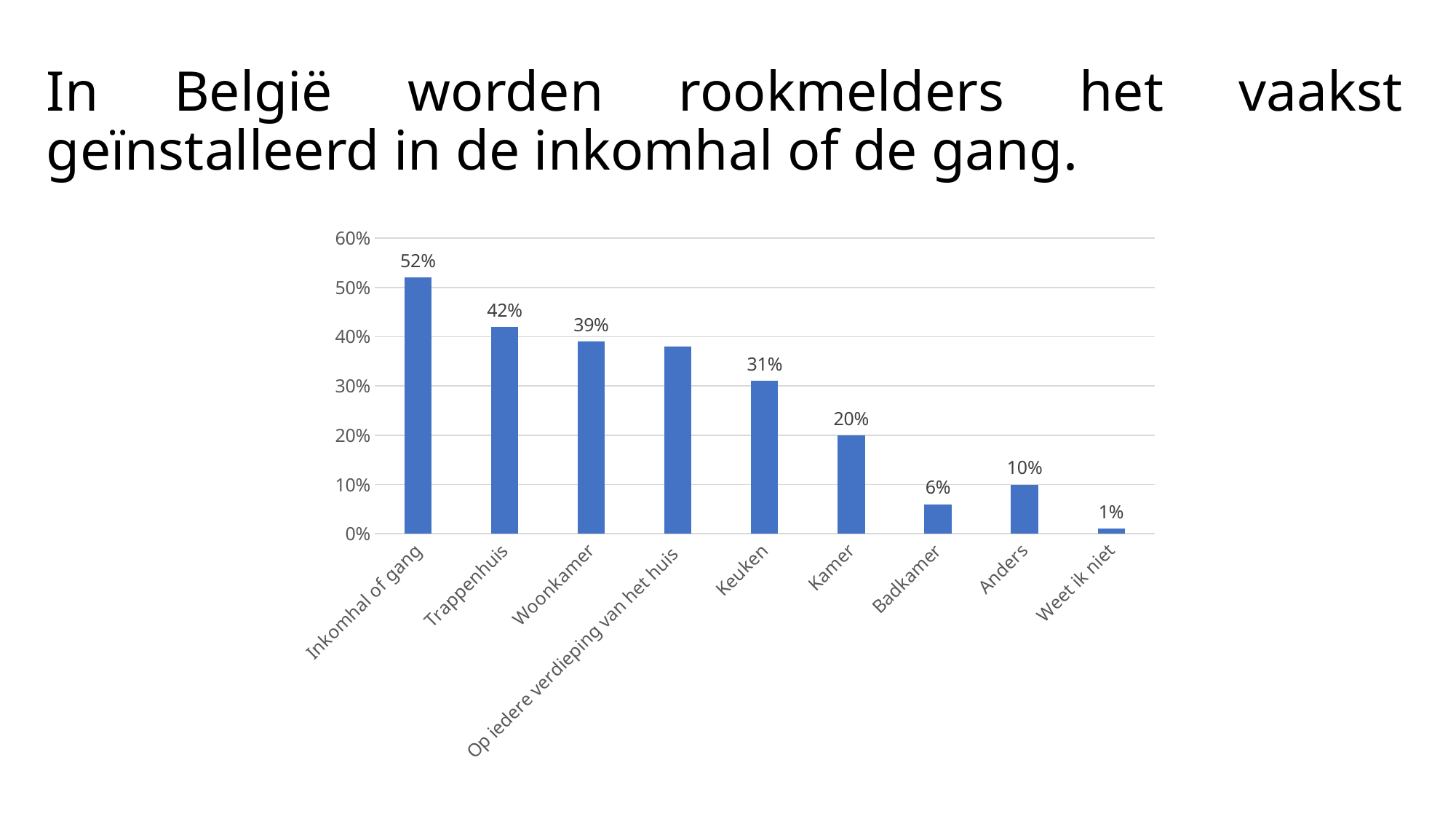
What colour are the bars in the chart? blue What kind of chart is shown on the slide? bar chart What is the difference between the values for Inkomhal of gang and Keuken? 21% Which category has the highest value? Inkomhal of gang Which is larger, the value for Badkamer or the value for Anders? Anders How many categories are shown on the x axis? 9 Which category has the lowest value? Weet ik niet What is the value for Keuken? 31% What is the difference between the values for Trappenhuis and Woonkamer? 3% What is the value for Inkomhal of gang? 52% Is the value for Op iedere verdieping van het huis greater or less than 30%? greater What is the value for Kamer? 20%